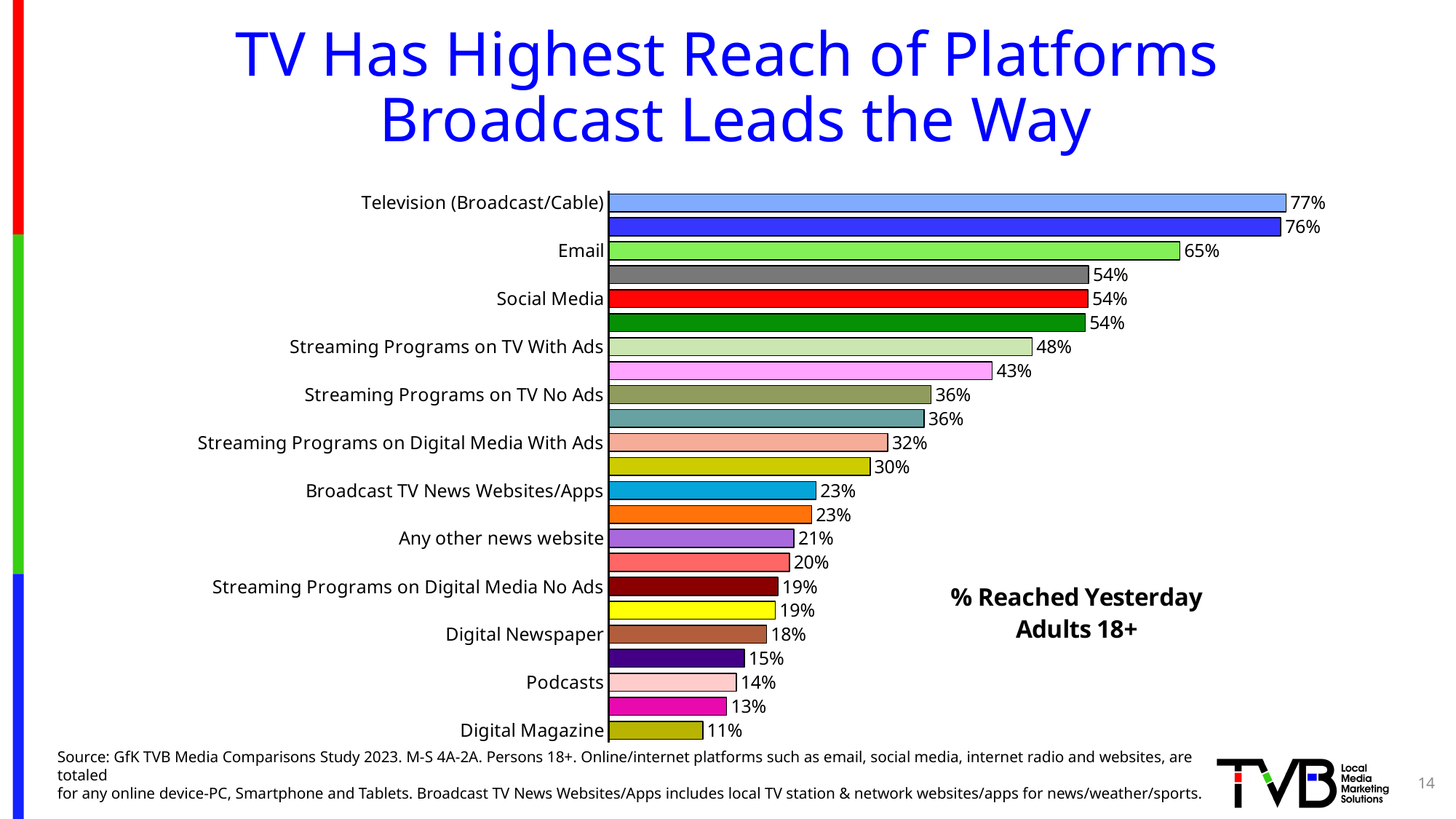
What is the value for Television (Broadcast/Cable)? 77% How many bars are plotted in the chart? 23 What is the value for Podcasts? 14% Which is larger, the value for Social Media or the value for Streaming Programs on TV No Ads? Social Media What kind of chart is shown on the slide? Bar chart What is the value for Email? 65% Which labeled category has the highest value? Television (Broadcast/Cable) What is the value for Streaming Programs on TV With Ads? 48% What is the value for Digital Newspaper? 18% Which labeled category has the lowest value? Digital Magazine What measure does the chart report, according to the text label inside the chart area? % Reached Yesterday, Adults 18+ What is the difference between the values for Television (Broadcast/Cable) and Email? 12 percentage points